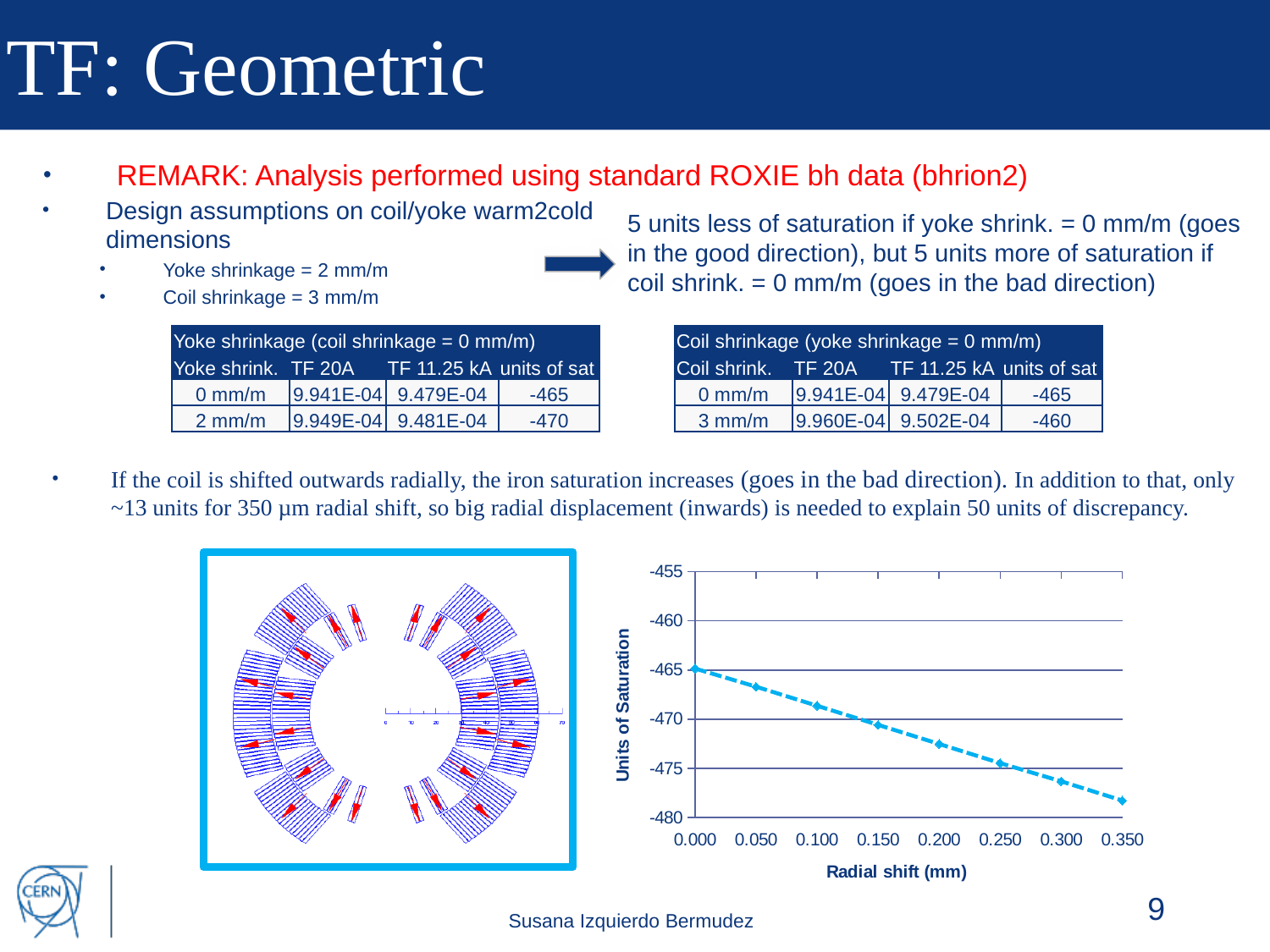
Do the Units of Saturation values rise or fall as the radial shift increases? fall What is the value of Units of Saturation at a radial shift of 0.000 mm? -465 What is the label of the x axis of the chart? Radial shift (mm) How many data points are plotted on the chart? 8 What is the label of the y axis of the chart? Units of Saturation At which radial shift is the Units of Saturation value highest? 0.000 Is the value for a radial shift of 0.050 mm greater or less than -470? greater What kind of chart is shown on the slide? line chart Is the value for a radial shift of 0.350 mm greater or less than -475? less Which has the larger Units of Saturation value: a radial shift of 0.100 mm or 0.300 mm? 0.100 mm At which radial shift is the Units of Saturation value lowest? 0.350 Is the value for a radial shift of 0.200 mm greater or less than -470? less